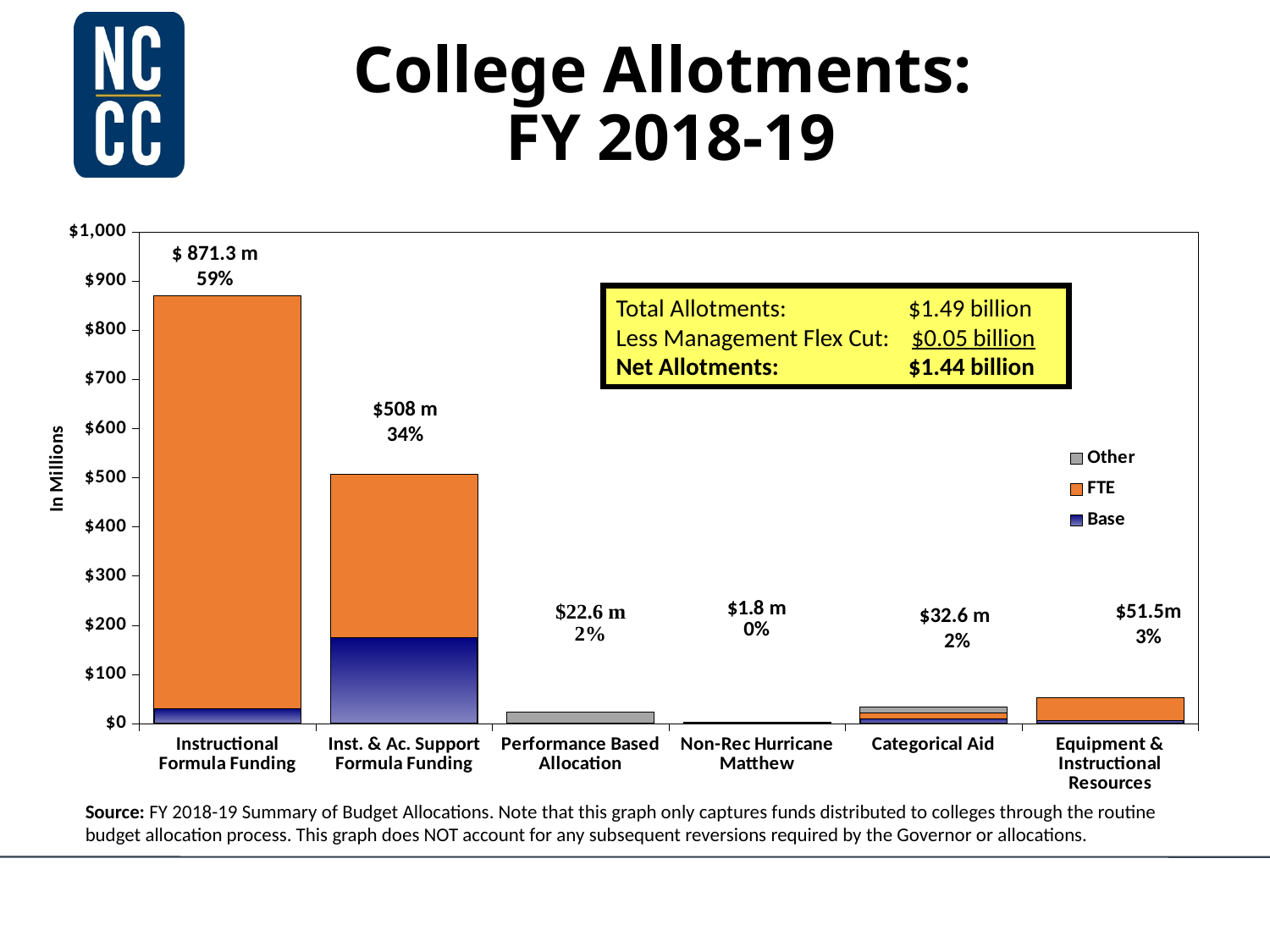
What percentage is shown above the Inst. & Ac. Support Formula Funding bar? 34% What kind of chart is shown on the slide? bar chart Which category has the highest allotment? Instructional Formula Funding Which is larger, the Categorical Aid allotment or the Performance Based Allocation? Categorical Aid What is the difference between the Instructional Formula Funding total and the Inst. & Ac. Support Formula Funding total? $363.3 m What value is labelled for the Non-Rec Hurricane Matthew bar? $1.8 m Which category has the lowest allotment? Non-Rec Hurricane Matthew How many series does the legend list? 3 What is the total value labelled for the Instructional Formula Funding bar? $ 871.3 m What share of allotments does Equipment & Instructional Resources represent? 3% How many categories are shown on the x axis? 6 Is the value for Inst. & Ac. Support Formula Funding greater or less than $600? less